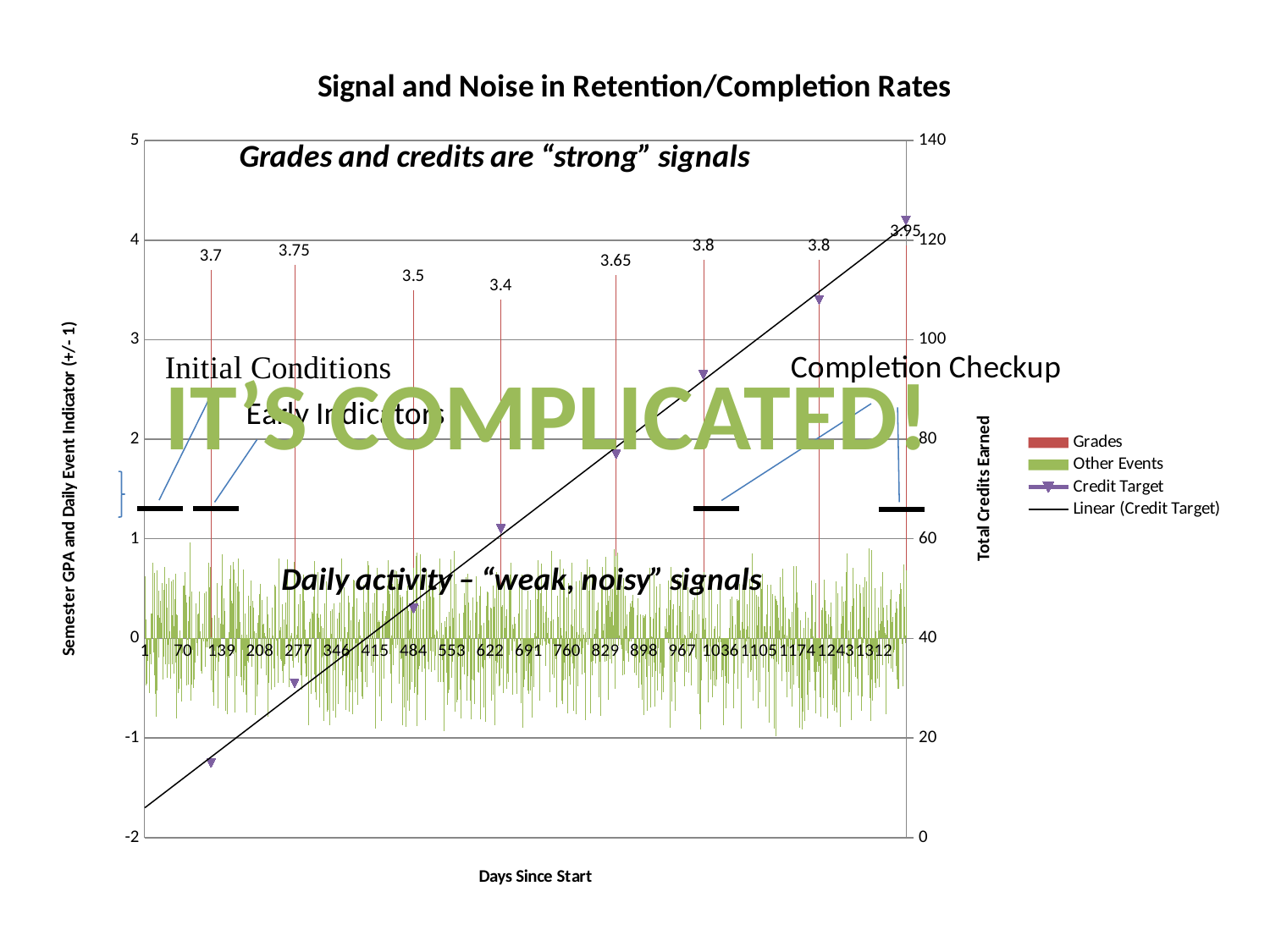
What is the label of the right-hand vertical axis? Total Credits Earned Does the Credit Target series rise or fall along the x axis? rise What is the last (rightmost) Grades value labeled on the chart? 3.95 What is the difference between the highest and lowest labeled Grades values? 0.55 What is the lowest Grades value labeled on the chart? 3.4 Which is larger, the second labeled Grades value (3.75) or the fourth labeled Grades value (3.4)? 3.75 What is the highest Grades value labeled on the chart? 3.95 How many series does the legend list? 4 What is the title of the chart? Signal and Noise in Retention/Completion Rates Is the last Credit Target point greater or less than 100 on the right axis? greater What is the first (leftmost) Grades value labeled on the chart? 3.7 How many Grades data labels are shown on the chart? 8